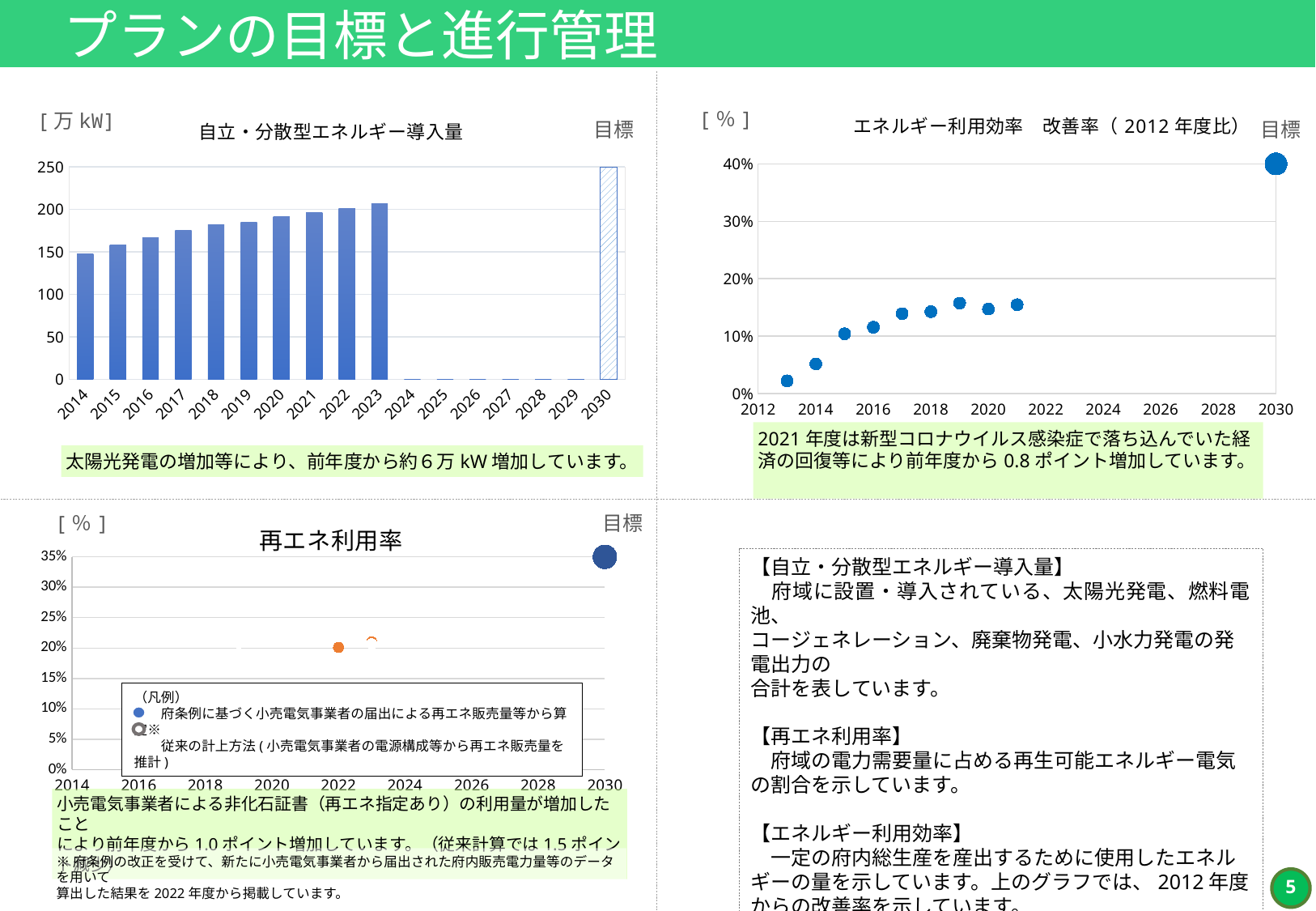
In the エネルギー利用効率 改善率 chart (top right), is the value for 2013 greater or less than 10%? less In the 自立・分散型エネルギー導入量 chart (top left), is the value for 2023 greater or less than 200? greater In the 自立・分散型エネルギー導入量 chart (top left), do the values rise or fall from 2014 to 2023? rise In the 自立・分散型エネルギー導入量 chart (top left), what is the 2030 target (目標) value? 250 In the エネルギー利用効率 改善率 chart (top right), what is the 2030 target (目標) value? 40% In the 自立・分散型エネルギー導入量 chart (top left), which year from 2014 to 2023 has the highest bar? 2023 In the 自立・分散型エネルギー導入量 chart (top left), which year from 2014 to 2023 has the lowest bar? 2014 In the 再エネ利用率 chart (bottom left), what is the 2030 target (目標) value? 35% In the 再エネ利用率 chart (bottom left), how many series does the legend list? 2 What kind of chart is the 自立・分散型エネルギー導入量 chart (top left)? bar chart In the エネルギー利用効率 改善率 chart (top right), is the value for 2021 greater or less than 20%? less In the 自立・分散型エネルギー導入量 chart (top left), how many years are shown on the x axis? 17